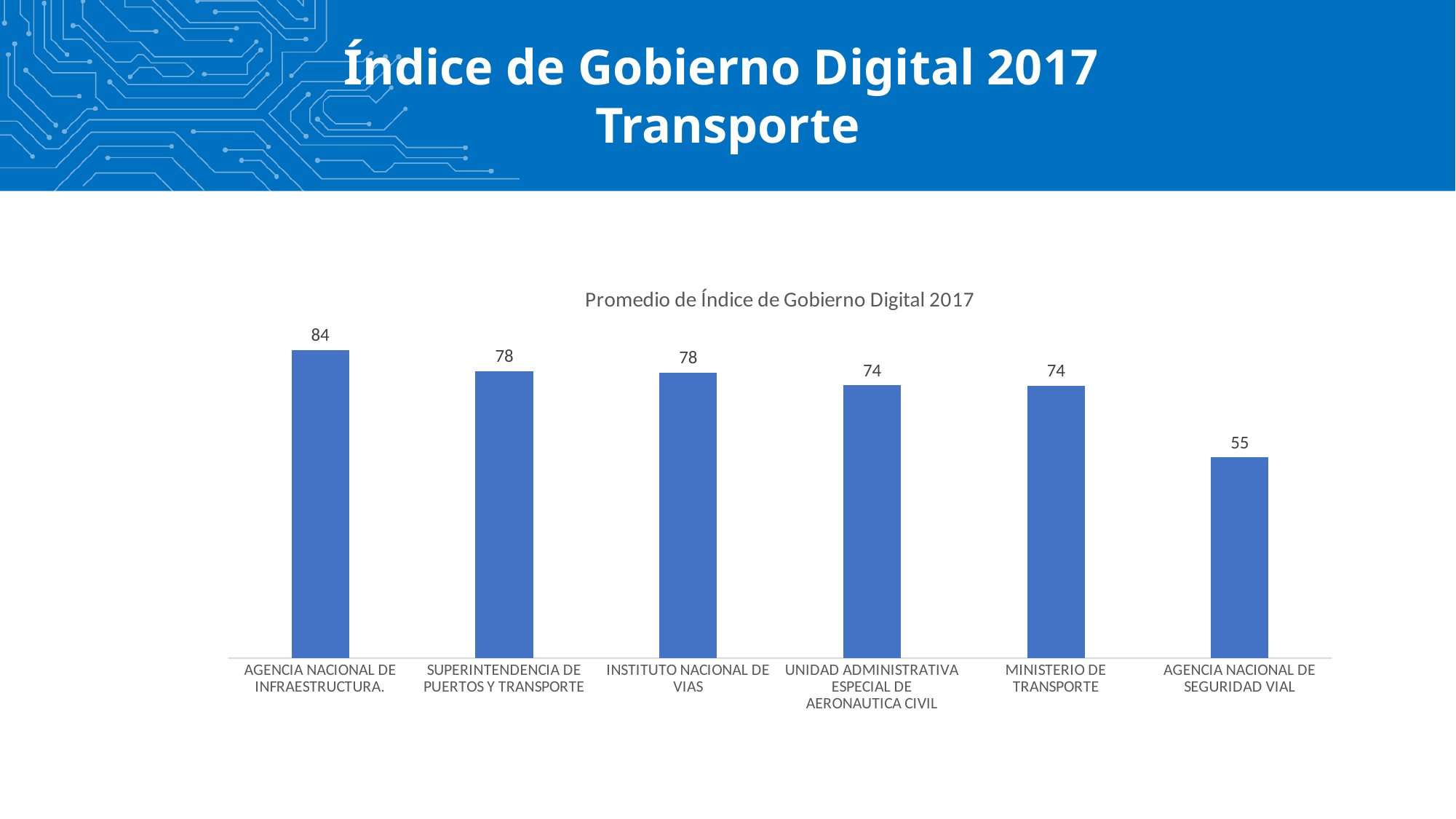
Which category has the highest value? AGENCIA NACIONAL DE INFRAESTRUCTURA What is the title of the chart? Promedio de Índice de Gobierno Digital 2017 What is the value for AGENCIA NACIONAL DE SEGURIDAD VIAL? 55 Which category has the lowest value? AGENCIA NACIONAL DE SEGURIDAD VIAL Which is larger, the value for SUPERINTENDENCIA DE PUERTOS Y TRANSPORTE or the value for MINISTERIO DE TRANSPORTE? SUPERINTENDENCIA DE PUERTOS Y TRANSPORTE What kind of chart is shown on the slide? Bar chart What is the value for INSTITUTO NACIONAL DE VIAS? 78 What is the value for AGENCIA NACIONAL DE INFRAESTRUCTURA? 84 What is the difference between the values for SUPERINTENDENCIA DE PUERTOS Y TRANSPORTE and UNIDAD ADMINISTRATIVA ESPECIAL DE AERONAUTICA CIVIL? 4 How many categories are shown in the chart? 6 What is the value for MINISTERIO DE TRANSPORTE? 74 What is the difference between the values for AGENCIA NACIONAL DE INFRAESTRUCTURA and AGENCIA NACIONAL DE SEGURIDAD VIAL? 29